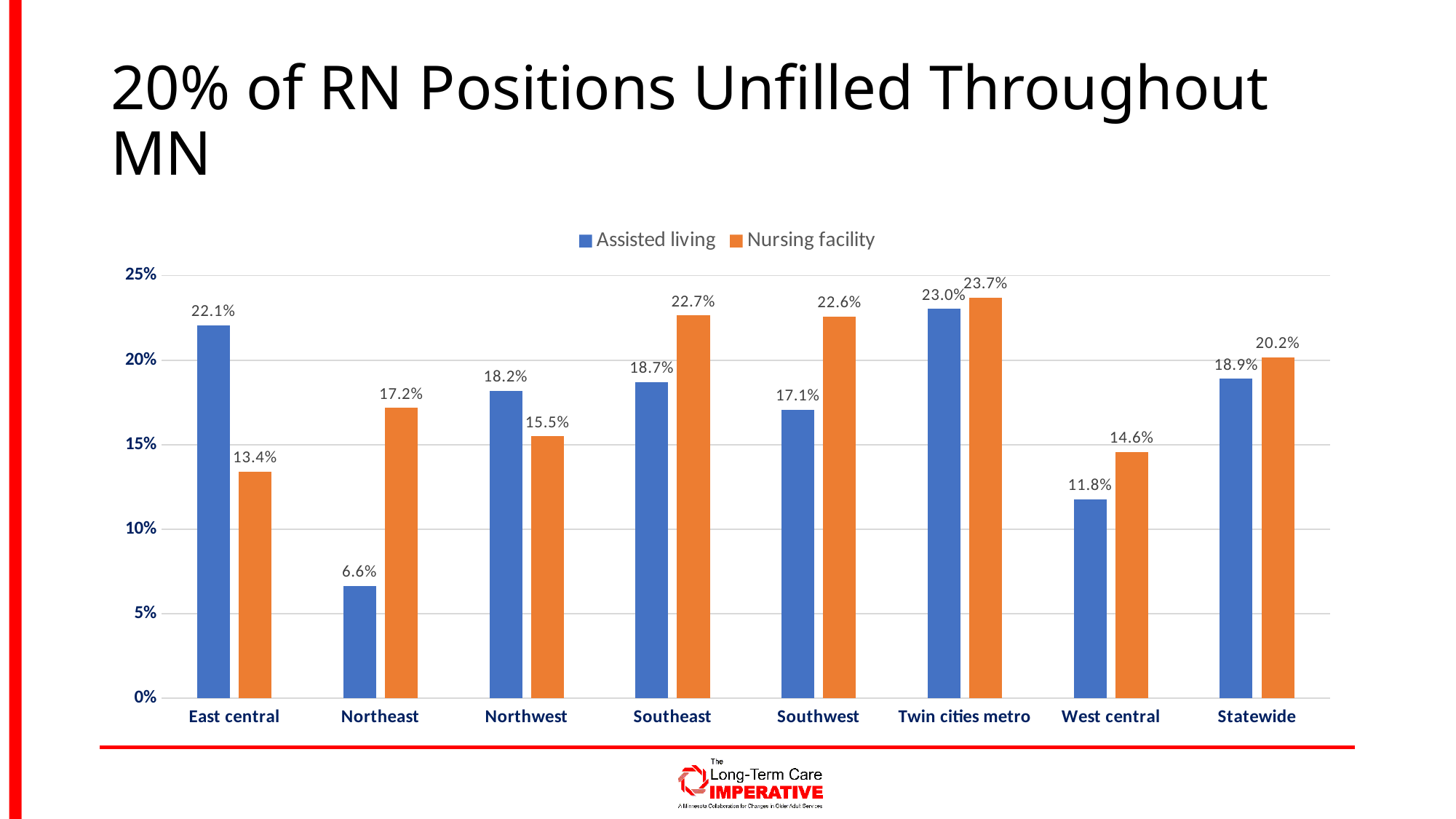
What is the Nursing facility value for Twin cities metro? 23.7% What is the difference between the Nursing facility and Assisted living values for East central? 8.7% How many categories are shown on the x axis? 8 Which region has the lowest Assisted living value? Northeast What kind of chart is shown on the slide? Bar chart How many series does the legend list? 2 What is the Assisted living value for Northeast? 6.6% Which region has the highest Nursing facility value? Twin cities metro Which colour represents Nursing facility in the chart? Orange What is the Statewide value for Assisted living? 18.9% Which is larger for Northwest: Assisted living or Nursing facility? Assisted living Is the Assisted living value for West central greater or less than 15%? less